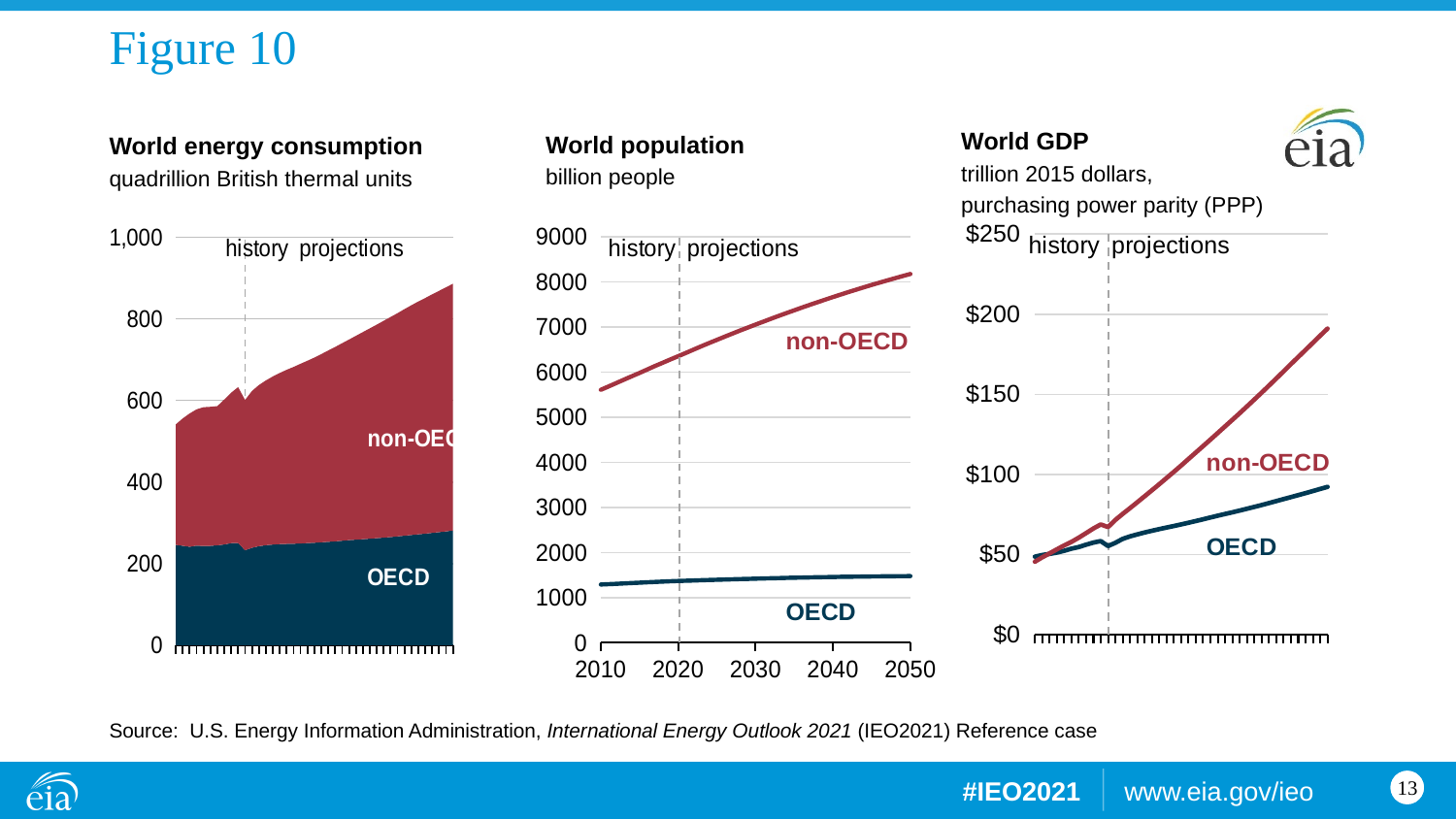
In the World GDP chart, does the non-OECD line rise or fall over the projection period? rise In the World GDP chart, is the non-OECD value at the end of the projection period greater or less than $150? greater How many series does the World GDP chart show? 2 In the World population chart, which series is larger in 2050, non-OECD or OECD? non-OECD In the World GDP chart, is the OECD value at the end of the projection period greater or less than $100? less What unit is the World energy consumption chart measured in? quadrillion British thermal units In the World population chart, is the OECD value in 2050 greater or less than 2000? less What unit is the World GDP chart measured in? trillion 2015 dollars, purchasing power parity (PPP) What kind of chart is the World population chart? line chart What kind of chart is the World energy consumption chart? stacked area chart